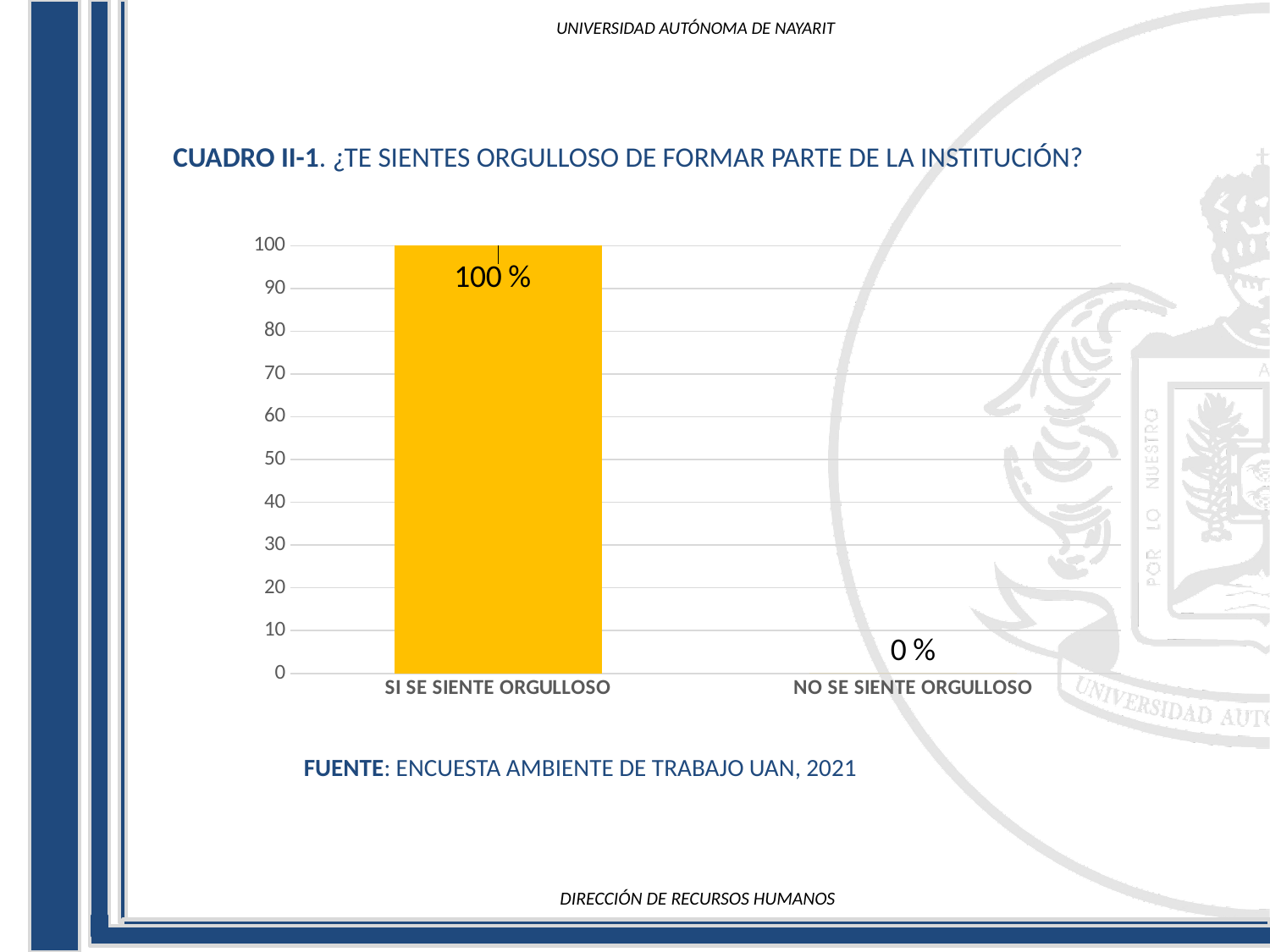
Is the value for SI SE SIENTE ORGULLOSO greater or less than 50? greater What kind of chart is shown on the slide? bar chart Which category has the highest value? SI SE SIENTE ORGULLOSO What colour is the bar for SI SE SIENTE ORGULLOSO? yellow What is the value for SI SE SIENTE ORGULLOSO? 100 % How many categories are shown on the x axis? 2 Which category has the lowest value? NO SE SIENTE ORGULLOSO What is the difference between the values for SI SE SIENTE ORGULLOSO and NO SE SIENTE ORGULLOSO? 100 % Which is larger, the value for SI SE SIENTE ORGULLOSO or NO SE SIENTE ORGULLOSO? SI SE SIENTE ORGULLOSO What is the value for NO SE SIENTE ORGULLOSO? 0 % What is the highest value shown on the vertical axis? 100